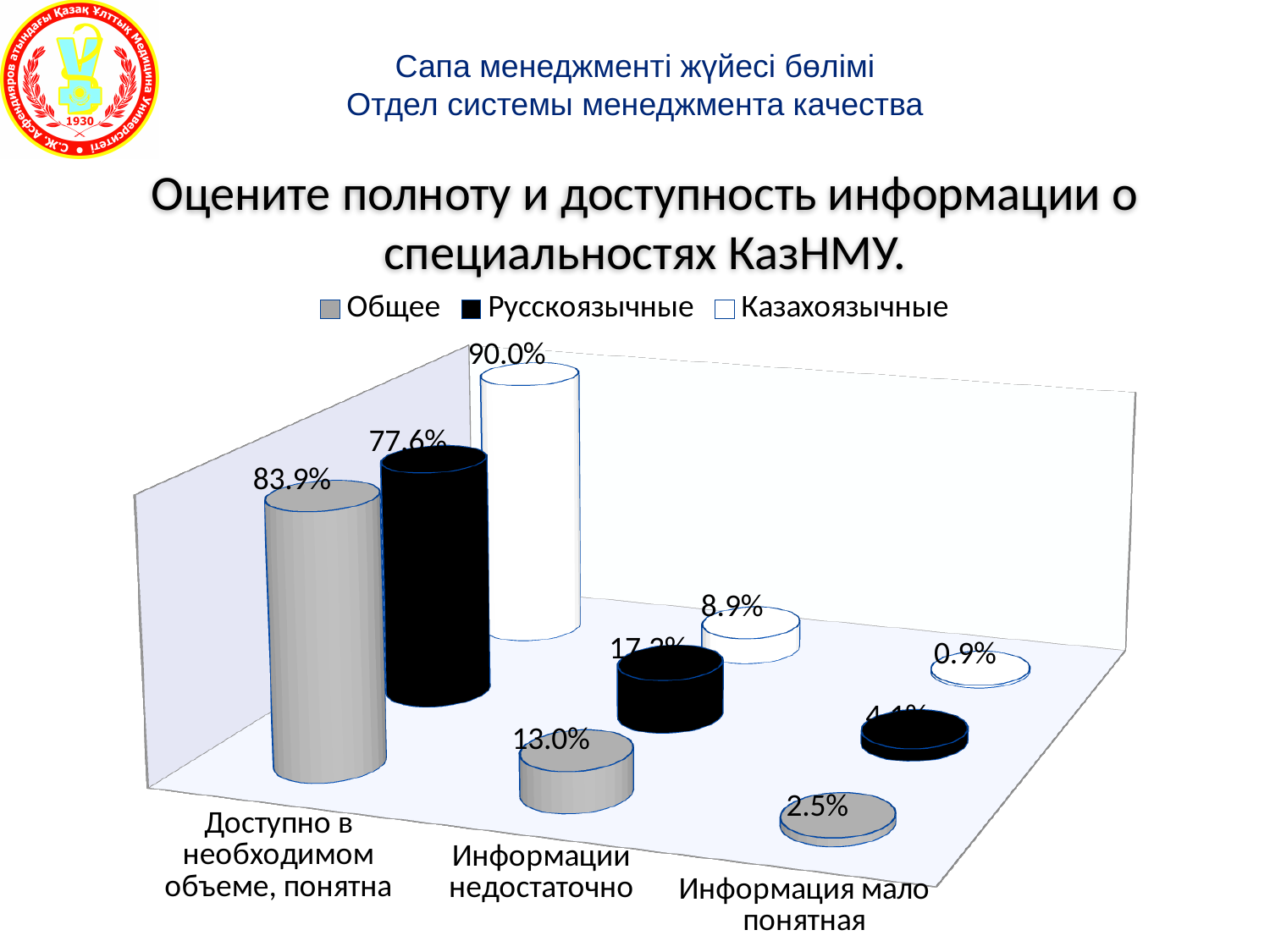
How many series does the legend list? 3 Which series has the highest value in the category 'Доступно в необходимом объеме, понятна'? Казахоязычные What is the value for Казахоязычные in the category 'Информация мало понятная'? 0.9% What is the value for Общее in the category 'Доступно в необходимом объеме, понятна'? 83.9% Which is larger in the category 'Информации недостаточно': the Общее value or the Казахоязычные value? Общее What kind of chart is shown on the slide? bar chart What is the value for Русскоязычные in the category 'Доступно в необходимом объеме, понятна'? 77.6% What is the difference between the Казахоязычные and Общее values in the category 'Доступно в необходимом объеме, понятна'? 6.1% What is the value for Казахоязычные in the category 'Доступно в необходимом объеме, понятна'? 90.0% Which category has the lowest value for the Общее series? Информация мало понятная How many categories are shown on the x axis? 3 What is the value for Общее in the category 'Информации недостаточно'? 13.0%